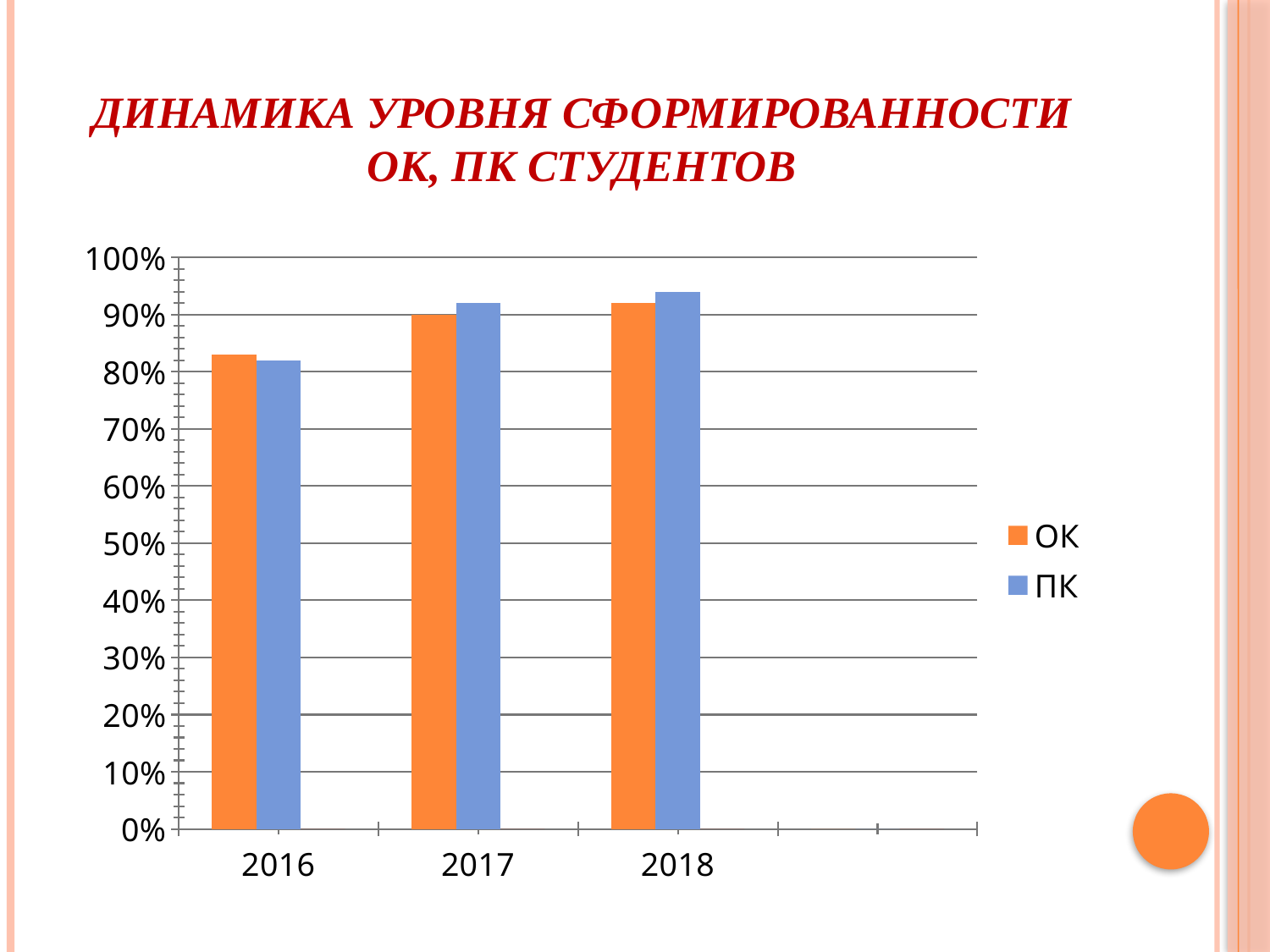
Is the value for ПК in 2016 greater or less than 90%? less Do the values for ПК rise or fall from 2016 to 2018? rise In which year is the value for ПК highest? 2018 In which year is the value for ОК lowest? 2016 How many years are shown on the x axis? 3 Which series is shown in orange? ОК Is the value for ОК in 2016 greater or less than 80%? greater How many series does the legend list? 2 What kind of chart is shown on the slide? bar chart In 2018, which is larger, ОК or ПК? ПК Is the value for ПК in 2017 greater or less than 90%? greater